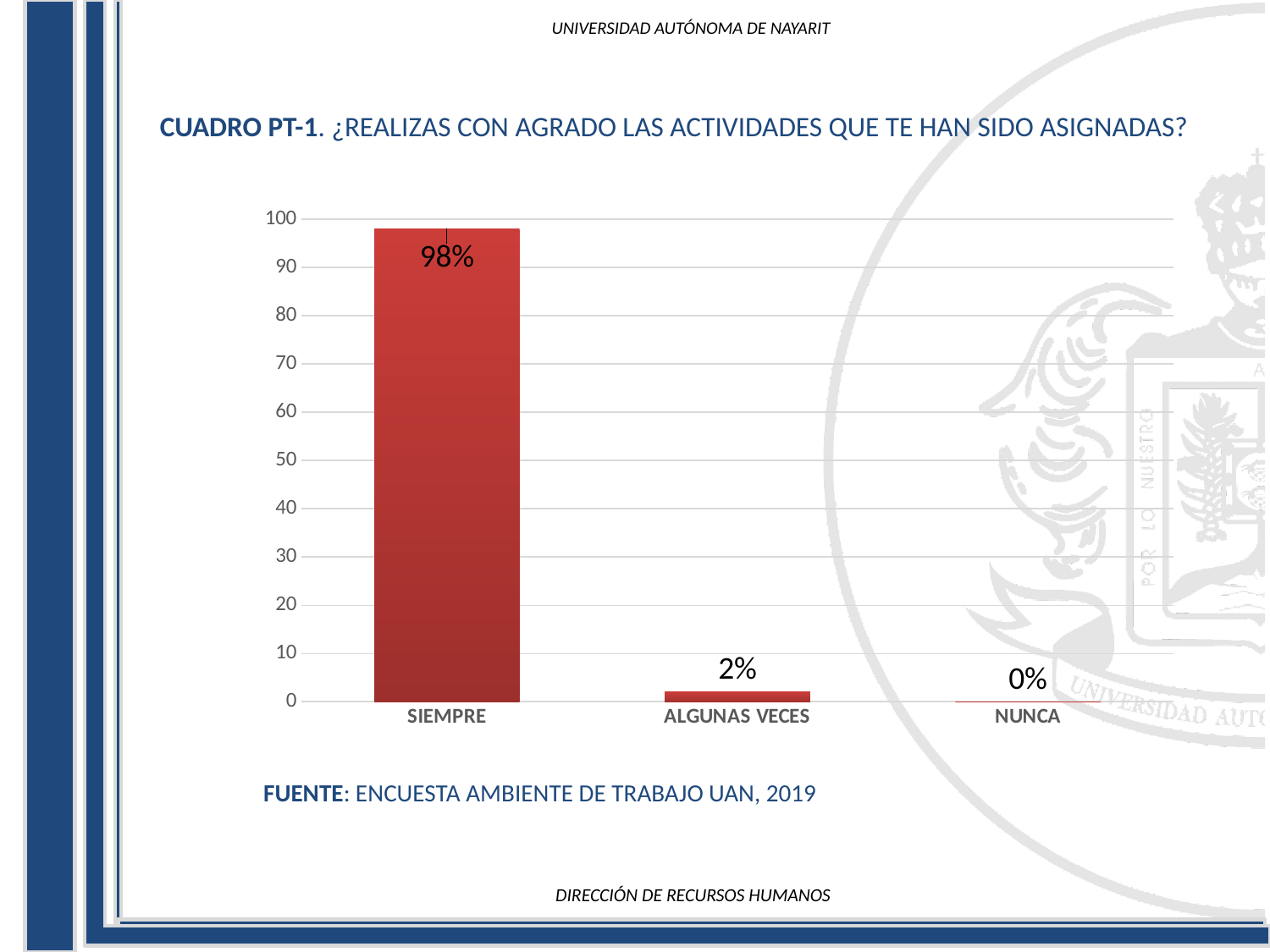
Is the value for SIEMPRE greater or less than 90? greater What is the value for NUNCA? 0% What kind of chart is shown on the slide? bar chart Which category has the lowest value? NUNCA What is the value for ALGUNAS VECES? 2% What source is cited below the chart? ENCUESTA AMBIENTE DE TRABAJO UAN, 2019 What is the value for SIEMPRE? 98% Which is larger, the value for ALGUNAS VECES or the value for NUNCA? ALGUNAS VECES What is the difference between the values for SIEMPRE and ALGUNAS VECES? 96% Do the values rise or fall from left to right along the x axis? fall Which category has the highest value? SIEMPRE How many categories are shown on the x axis? 3